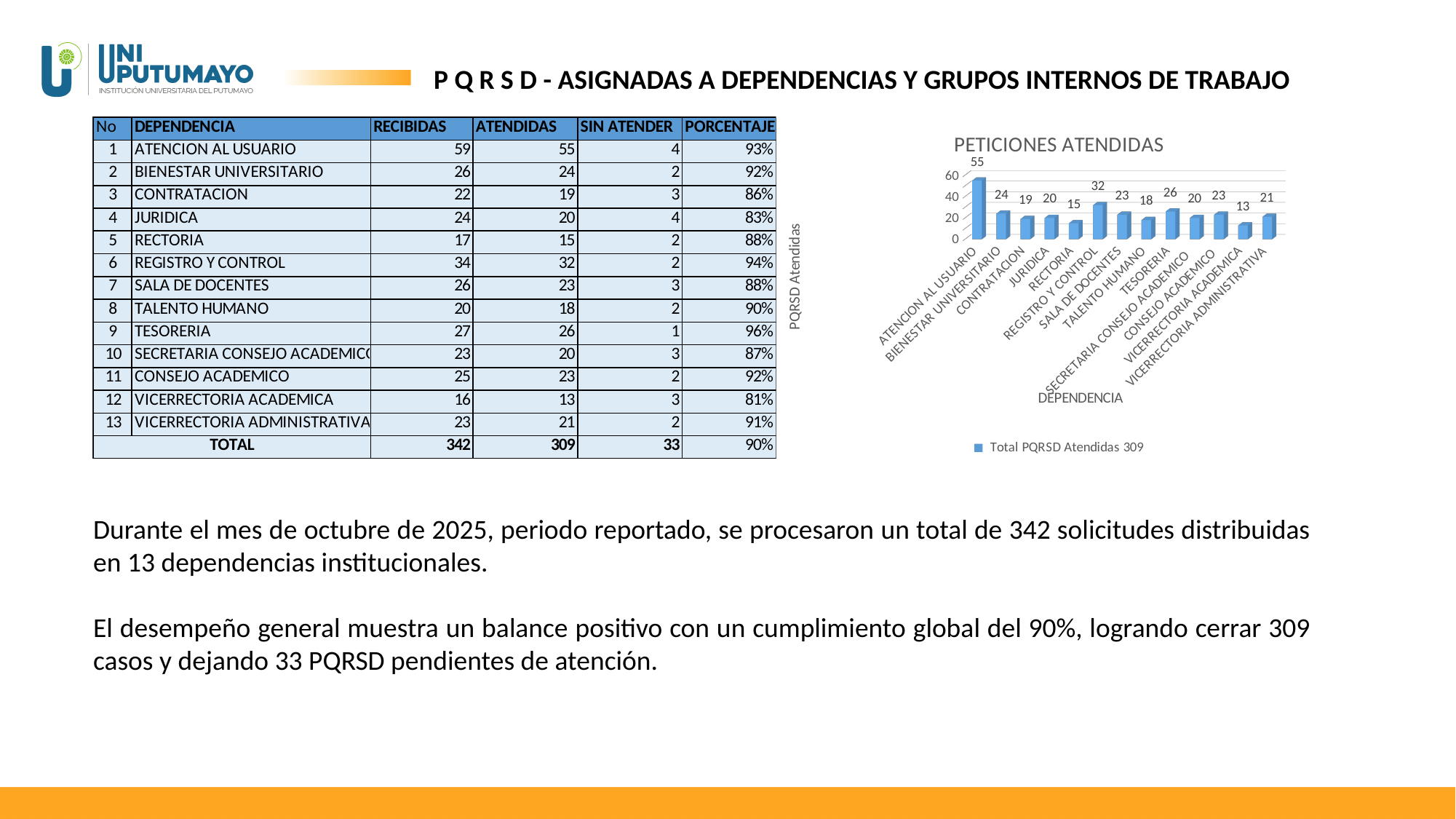
Which dependencia has the lowest value in the chart? VICERRECTORIA ACADEMICA Which dependencia has the highest value in the chart? ATENCION AL USUARIO Is the value for SALA DE DOCENTES greater or less than 20? greater What is the value for REGISTRO Y CONTROL in the chart? 32 Which is larger, the value for TESORERIA or the value for RECTORIA? TESORERIA What is the value for VICERRECTORIA ACADEMICA in the chart? 13 What is the title of the chart? PETICIONES ATENDIDAS What is the value for ATENCION AL USUARIO in the chart? 55 What is the difference between the values for ATENCION AL USUARIO and REGISTRO Y CONTROL? 23 What type of chart is shown? bar chart What is the legend entry of the chart? Total PQRSD Atendidas 309 How many dependencias are shown on the x axis of the chart? 13